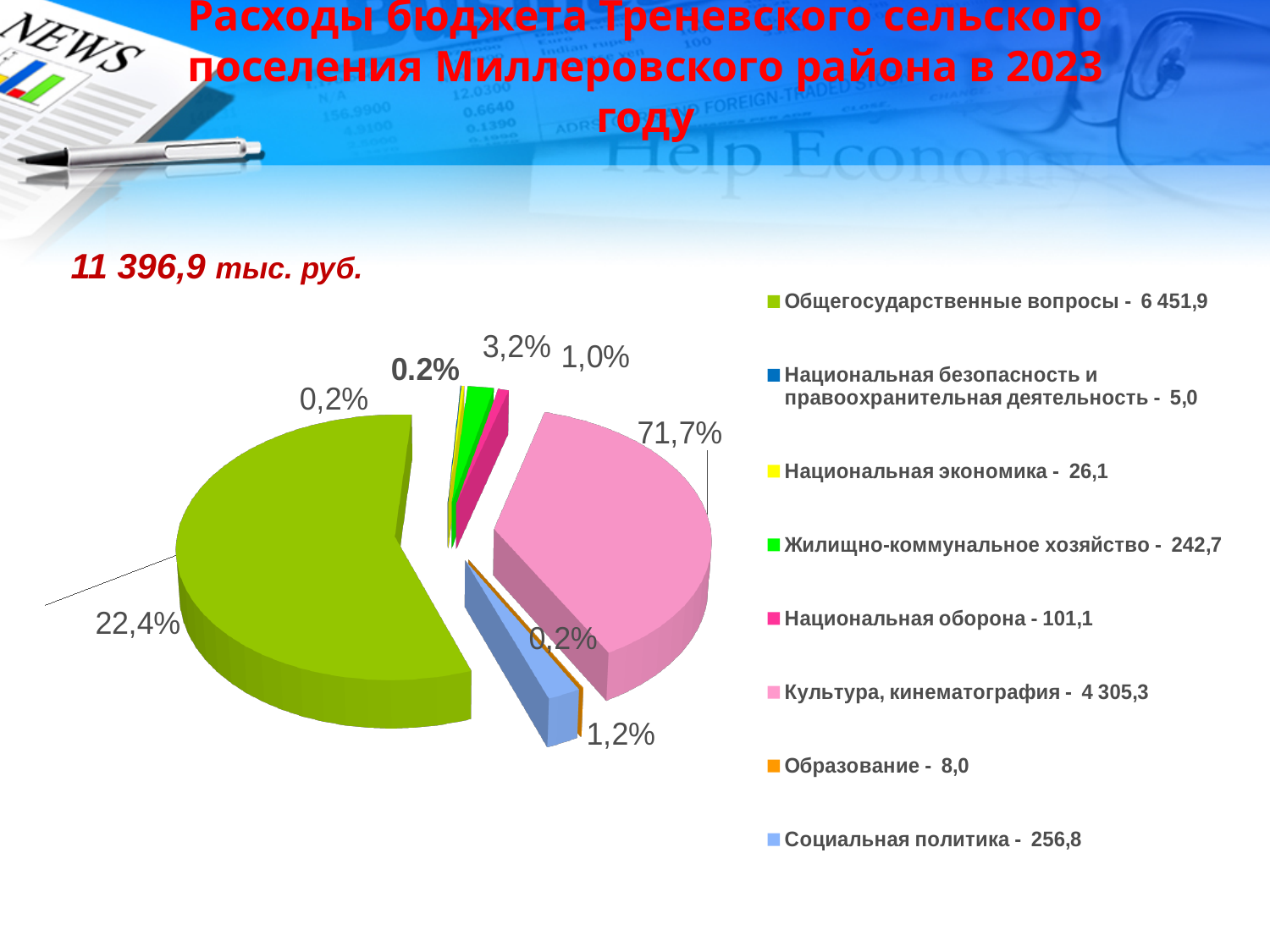
What value is shown in the legend for Национальная оборона? 101,1 Which category has the smallest value in the legend? Национальная безопасность и правоохранительная деятельность Which has the larger legend value: Национальная оборона or Национальная экономика? Национальная оборона What value is shown in the legend for Общегосударственные вопросы? 6 451,9 What value is shown in the legend for Культура, кинематография? 4 305,3 How many categories does the legend of the pie chart list? 8 What kind of chart is shown on the slide? pie chart Which category has the largest value in the legend? Общегосударственные вопросы What total amount of budget expenditure is stated on the slide above the chart? 11 396,9 тыс. руб. Which has the larger legend value: Жилищно-коммунальное хозяйство or Социальная политика? Социальная политика What value is shown in the legend for Социальная политика? 256,8 What is the difference between the legend values for Общегосударственные вопросы and Культура, кинематография? 2 146,6